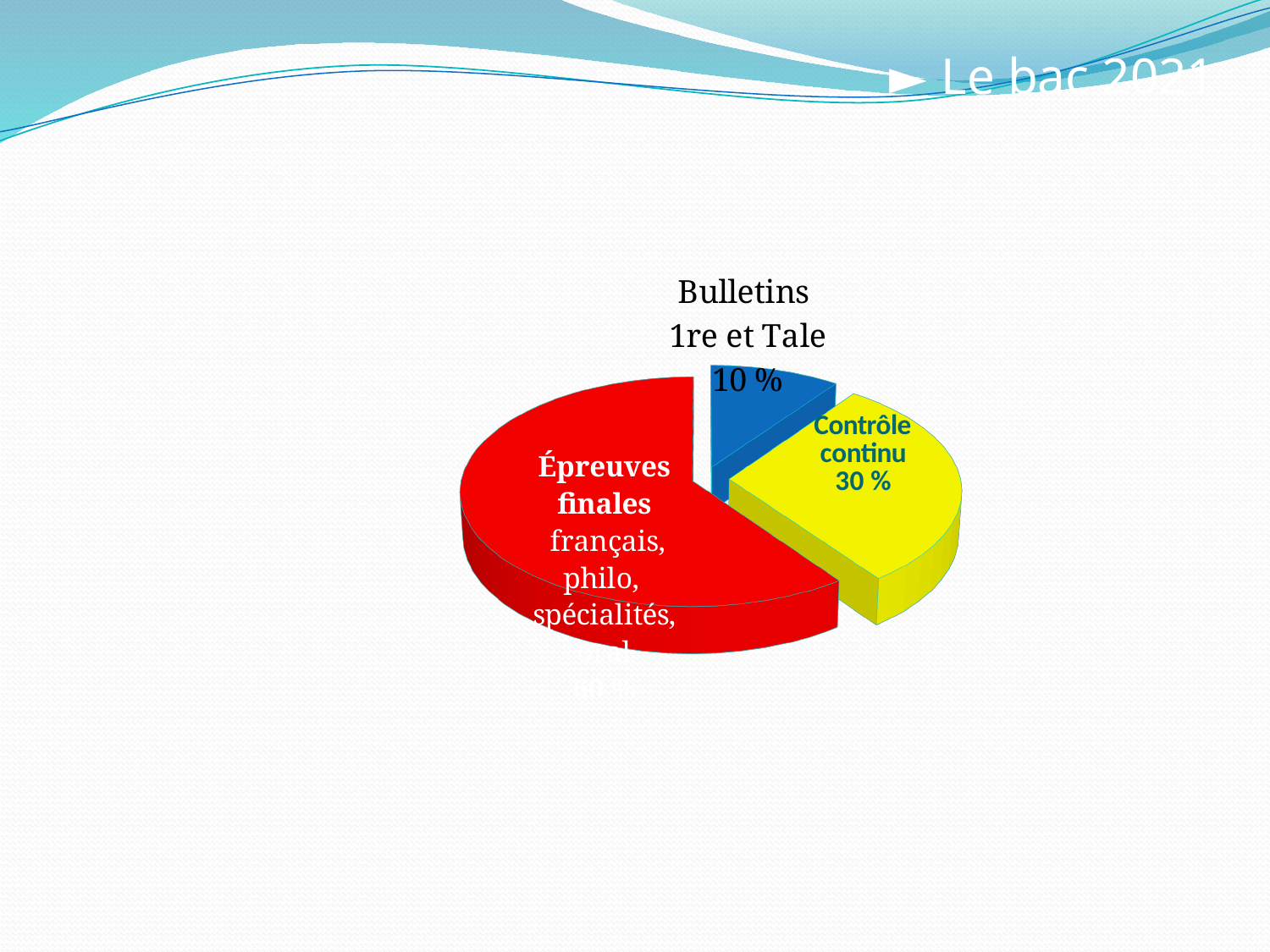
Which slice of the pie is the smallest? Bulletins 1re et Tale Which slice of the pie is the largest? Épreuves finales What share of the pie does the Épreuves finales slice represent? 60 % What colour is the Épreuves finales slice? red What is the difference in percentage points between the Épreuves finales slice and the Contrôle continu slice? 30 What colour is the Contrôle continu slice? yellow What kind of chart is shown on the slide? pie chart What share of the pie does the Bulletins 1re et Tale slice represent? 10 % What share of the pie does the Contrôle continu slice represent? 30 % Which is larger, the Contrôle continu slice or the Bulletins 1re et Tale slice? Contrôle continu What is the difference in percentage points between the Contrôle continu slice and the Bulletins 1re et Tale slice? 20 How many slices does the pie chart have? 3